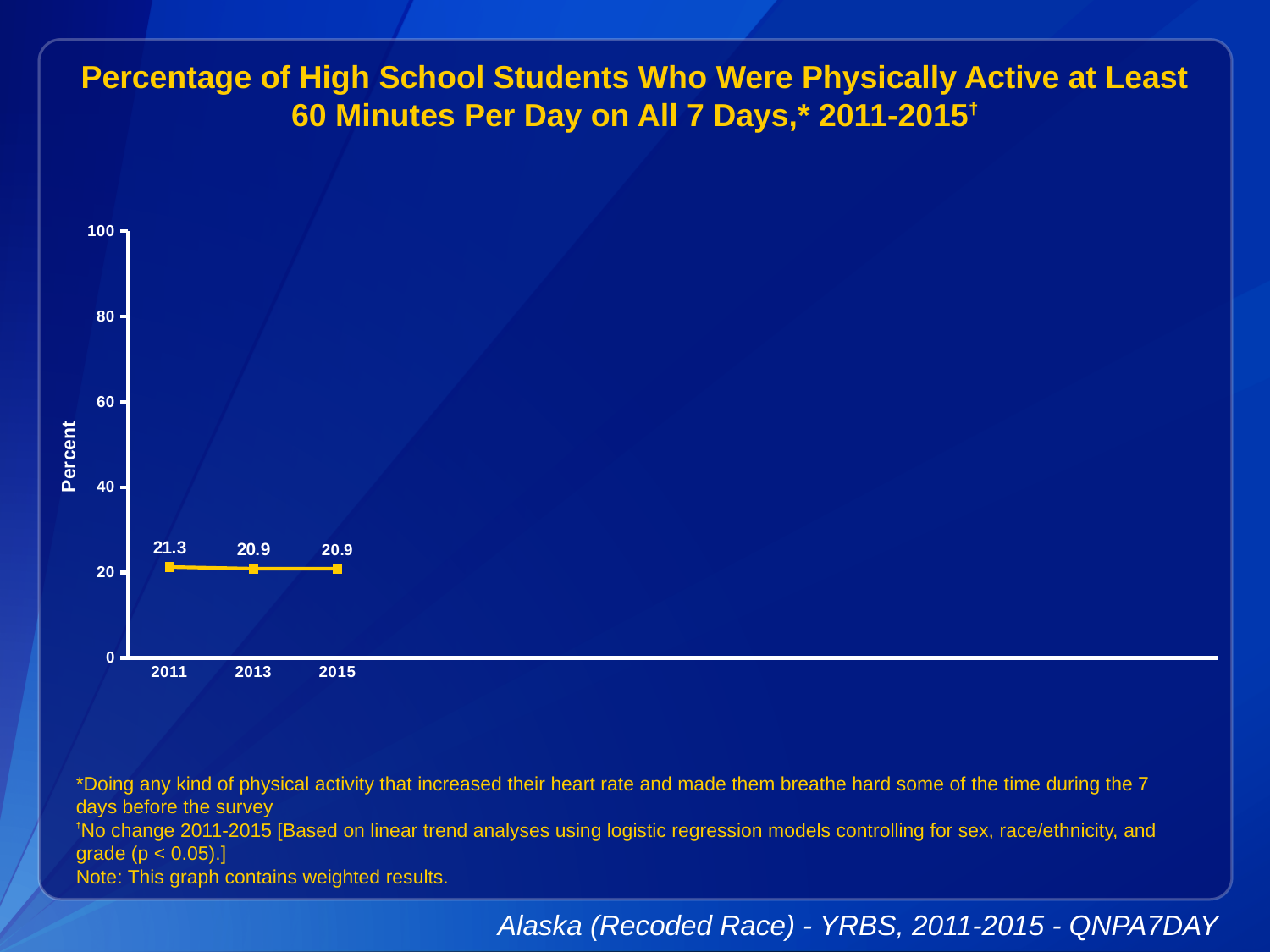
How many years are plotted on the chart? 3 What kind of chart is shown on the slide? line chart What is the maximum value shown on the y axis? 100 Do the values rise or fall from 2011 to 2015? fall What is the value for 2015? 20.9 What is the difference between the values for 2011 and 2015? 0.4 What is the value for 2013? 20.9 What is the label on the y axis? Percent What is the value for 2011? 21.3 Which year has the highest value? 2011 Which is larger, the value for 2011 or the value for 2013? 2011 Is the value for 2011 greater or less than 40? less